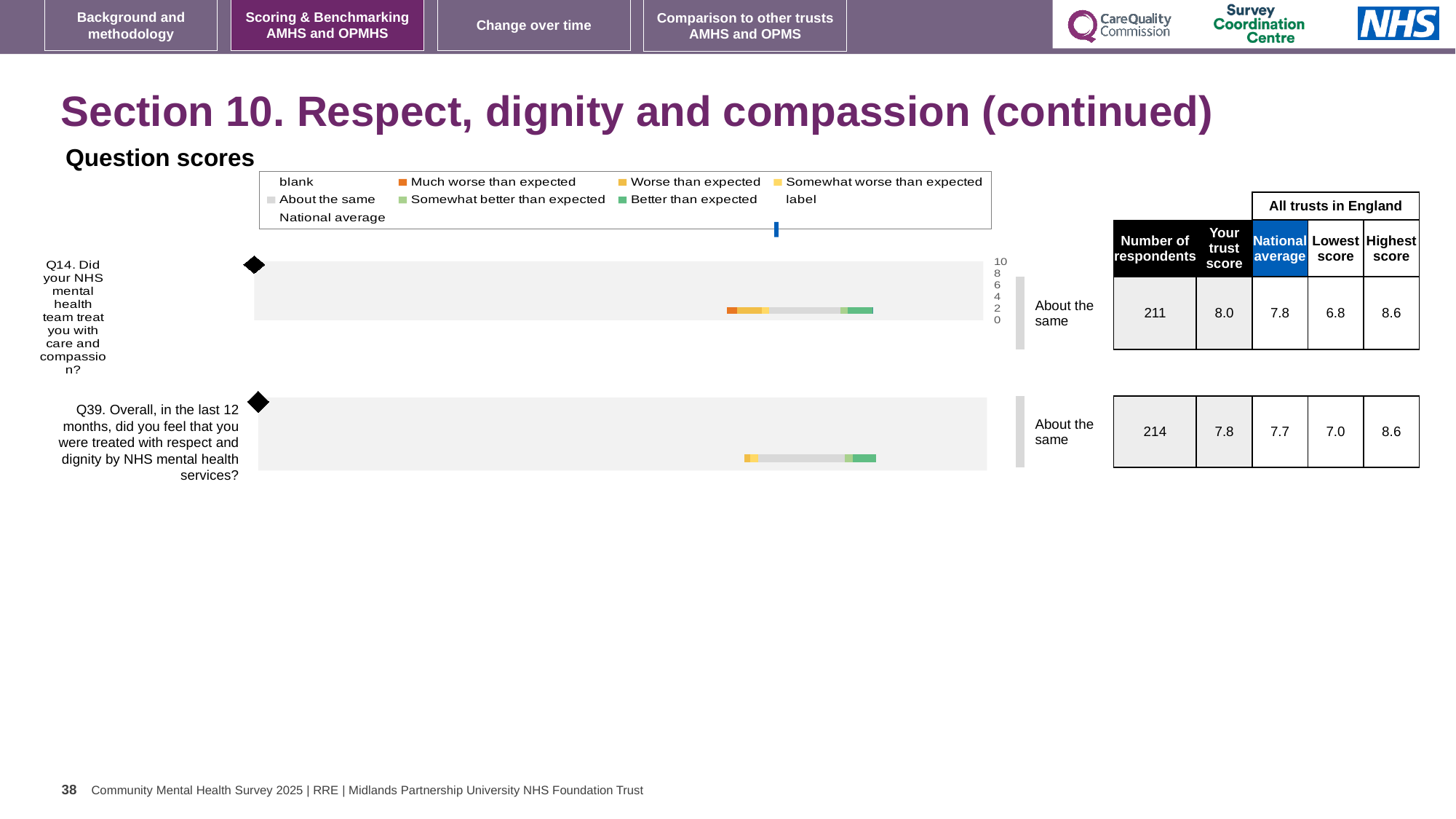
What kind of chart is used to show the question scores on this slide? bar chart What is the highest score across all trusts in England for Q14? 8.6 Which question has the higher trust score, Q14 or Q39? Q14 What is the difference between the trust score and the national average for Q14? 0.2 What is the national average for Q39 in the Question scores chart? 7.7 What is the lowest score across all trusts in England for Q39? 7.0 How many questions are plotted in the Question scores chart? 2 What is the number of respondents for Q14 in the Question scores chart? 211 What is the difference between the highest and lowest scores for Q39? 1.6 Which question has the larger number of respondents, Q14 or Q39? Q39 What is the trust score for Q14 (care and compassion) in the Question scores chart? 8.0 What benchmark category label is shown next to the bar for Q39? About the same